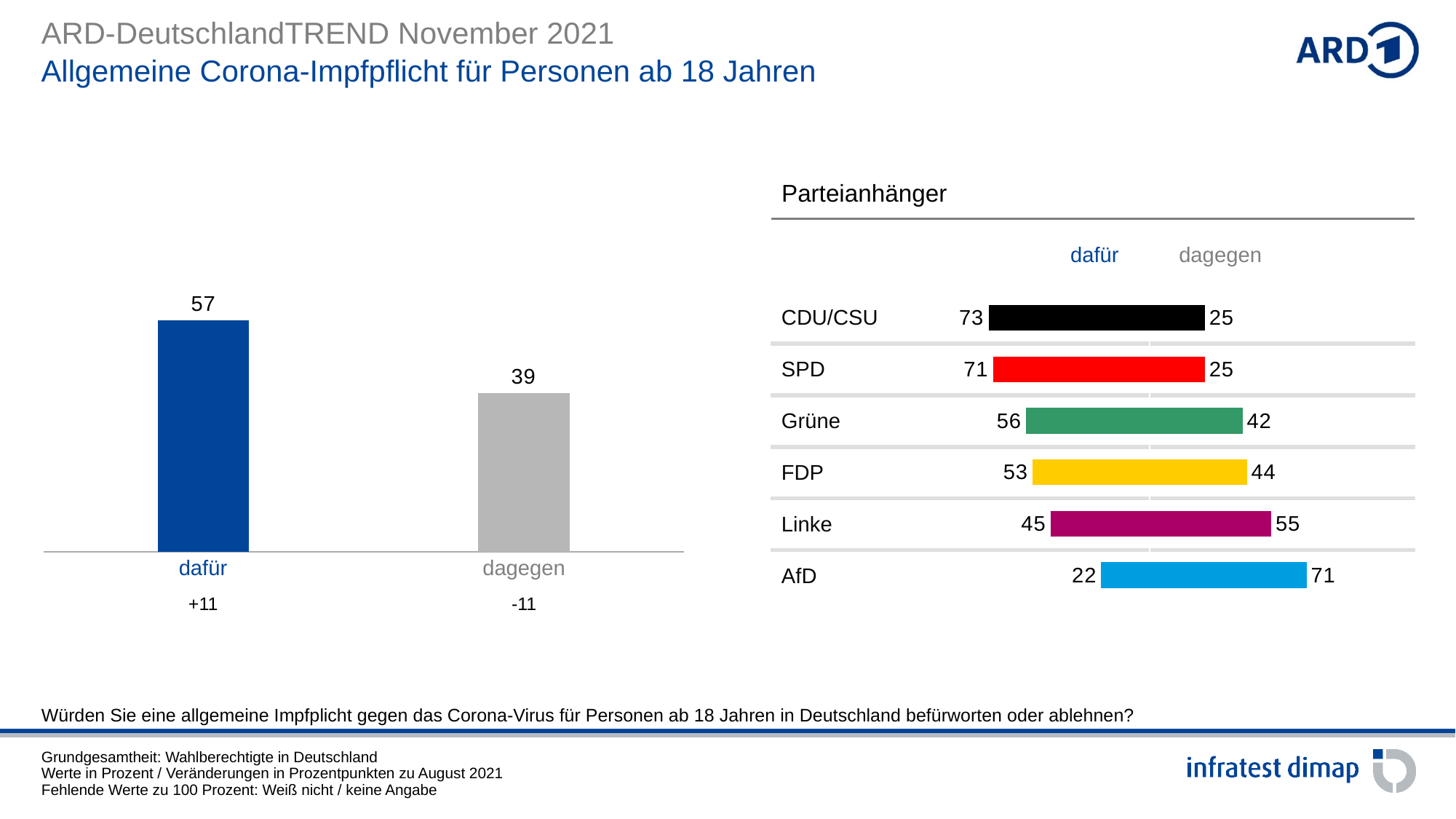
In the "Parteianhänger" chart, which party has the lowest "dafür" value? AfD What kind of chart is the left chart? bar chart In the left bar chart, what is the difference between the "dafür" and "dagegen" values? 18 In the "Parteianhänger" chart, what is the difference between the "dafür" and "dagegen" values for Grüne? 14 In the "Parteianhänger" chart, which party has the highest "dafür" value? CDU/CSU In the "Parteianhänger" chart, what is the "dagegen" value for AfD? 71 In the left bar chart, what is the value for "dafür"? 57 In the left bar chart, what change in percentage points is shown below "dafür"? +11 How many parties are listed in the "Parteianhänger" chart? 6 In the "Parteianhänger" chart, what is the "dafür" value for CDU/CSU? 73 In the "Parteianhänger" chart, which is larger for Linke: the "dafür" value or the "dagegen" value? dagegen In the left bar chart, what is the value for "dagegen"? 39